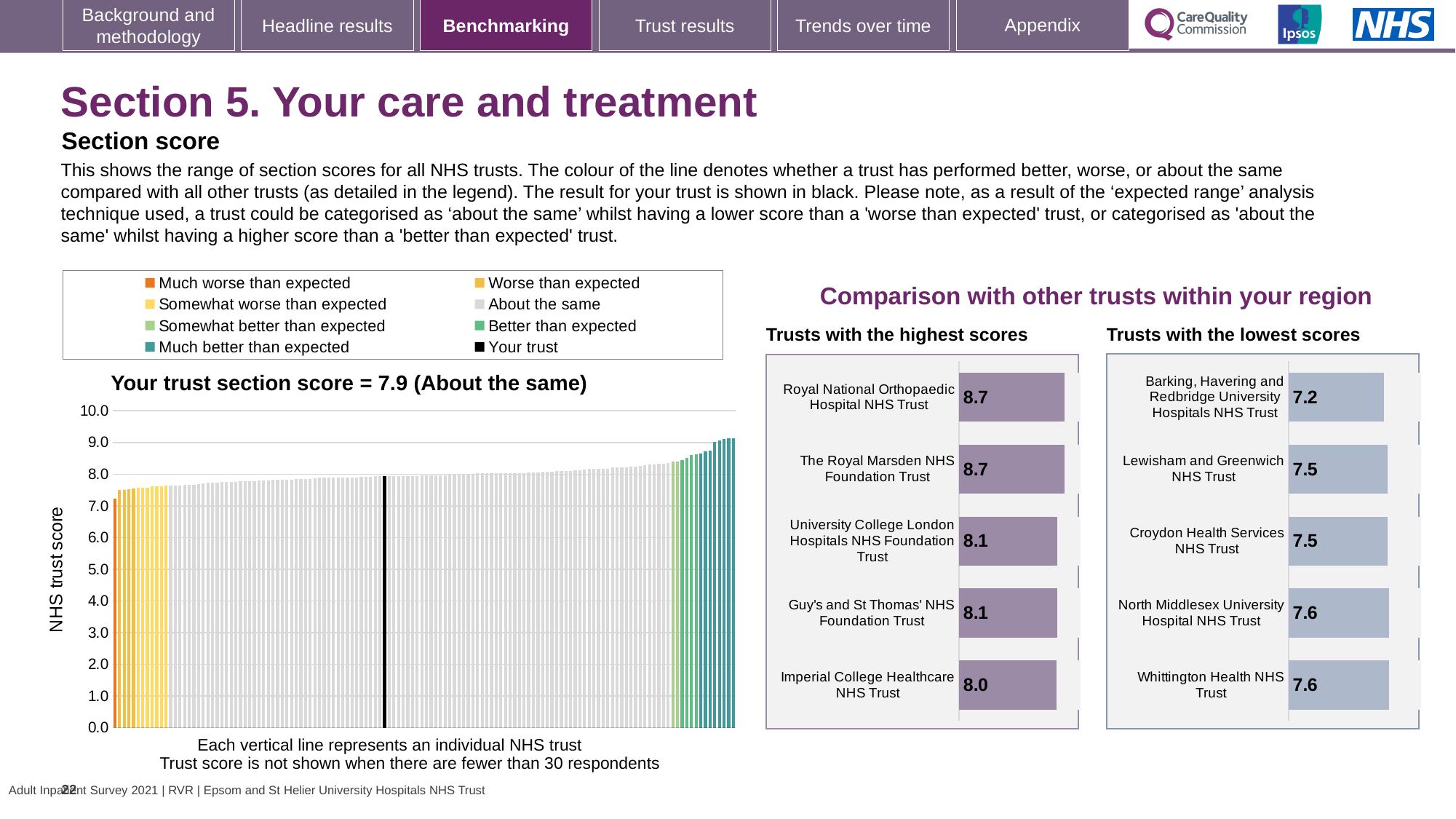
In the 'Trusts with the lowest scores' chart, what is the score for Barking, Havering and Redbridge University Hospitals NHS Trust? 7.2 In the main chart on the left, what is your trust's section score? 7.9 How many trusts are shown in the 'Trusts with the highest scores' chart? 5 In the 'Trusts with the highest scores' chart, what is the score for Imperial College Healthcare NHS Trust? 8.0 Which has the higher score: University College London Hospitals NHS Foundation Trust in the highest scores chart, or Whittington Health NHS Trust in the lowest scores chart? University College London Hospitals NHS Foundation Trust What kind of chart is the main chart on the left showing all NHS trusts? Bar chart What is the label on the vertical axis of the main chart on the left? NHS trust score In the 'Trusts with the lowest scores' chart, what is the score for Croydon Health Services NHS Trust? 7.5 In the main chart on the left, do the trust scores rise or fall from left to right? Rise In the 'Trusts with the lowest scores' chart, which trust has the lowest score? Barking, Havering and Redbridge University Hospitals NHS Trust In the 'Trusts with the highest scores' chart, what is the difference between the scores of Royal National Orthopaedic Hospital NHS Trust and Imperial College Healthcare NHS Trust? 0.7 How many entries does the legend above the main chart list? 8